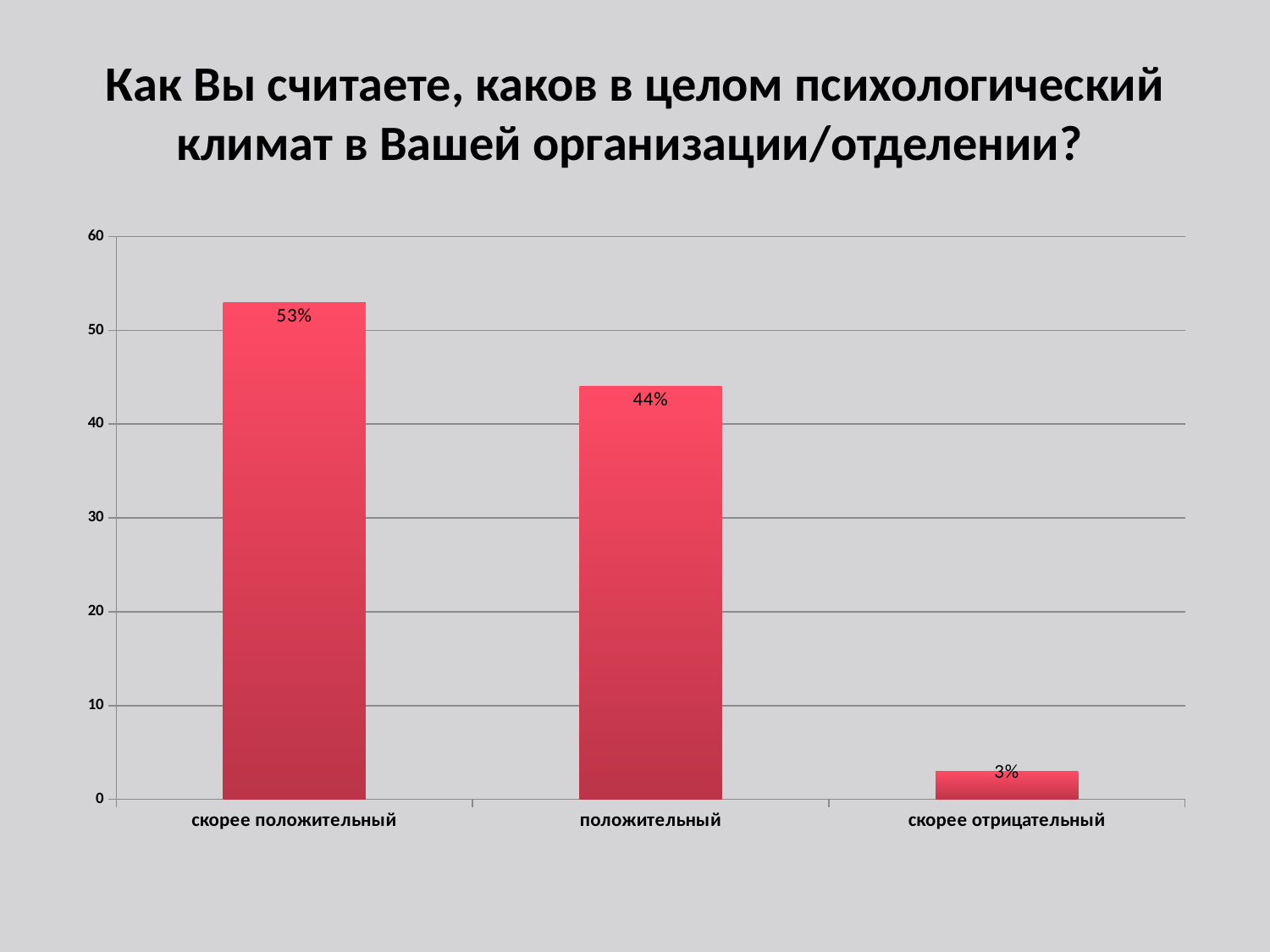
Is the value for "скорее положительный" greater or less than 50? greater What is the difference between the values for "положительный" and "скорее отрицательный"? 41% What is the difference between the values for "скорее положительный" and "положительный"? 9% Which category has the lowest value? скорее отрицательный What is the value for "скорее положительный"? 53% What kind of chart is shown on the slide? bar chart What is the value for "положительный"? 44% Do the values rise or fall from left to right along the x axis? fall Which is larger, the value for "положительный" or the value for "скорее отрицательный"? положительный What is the value for "скорее отрицательный"? 3% How many categories are shown on the x axis? 3 Which category has the highest value? скорее положительный